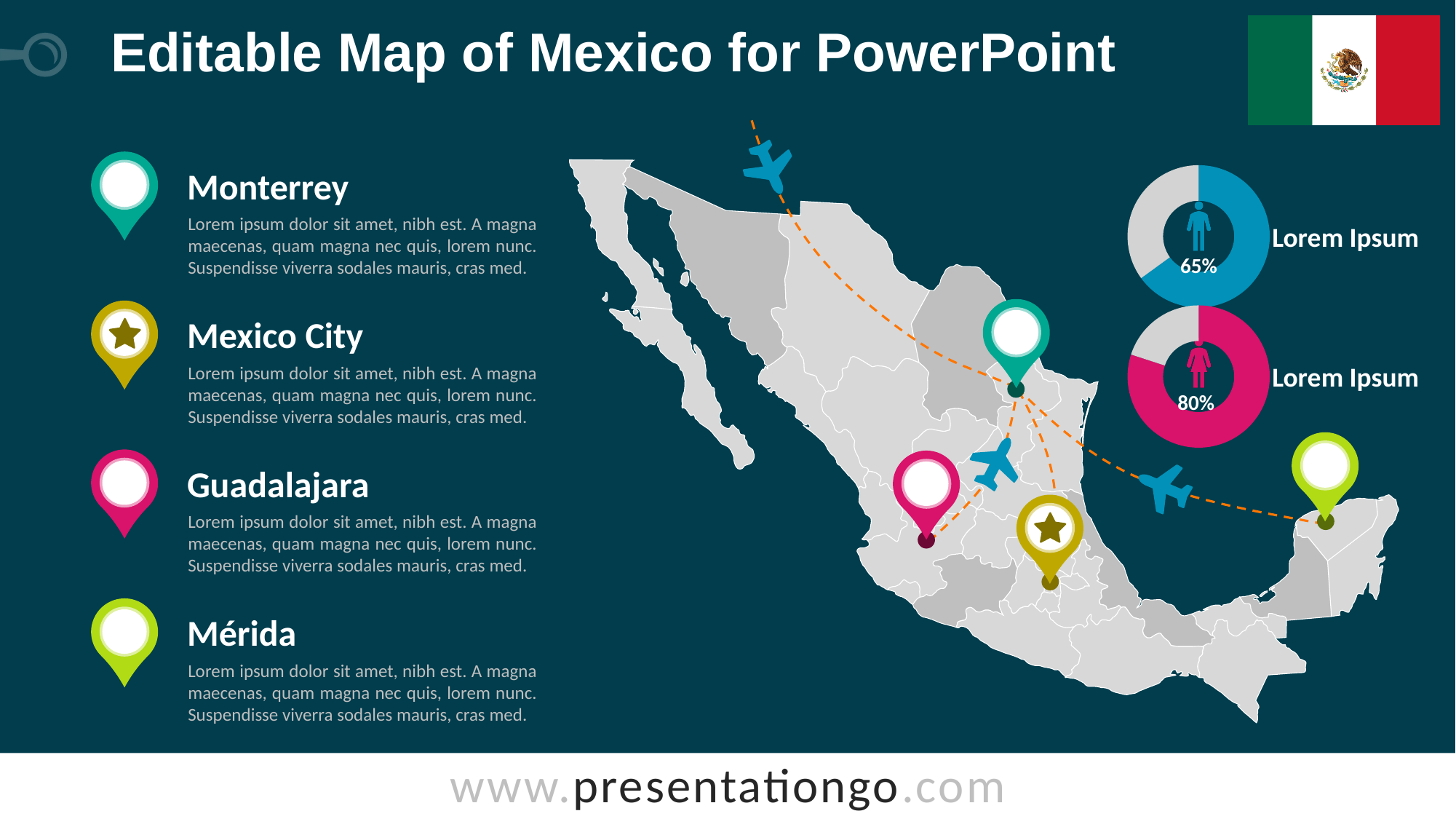
Is the value in the lower donut chart with the female icon greater or less than 75%? greater What kind of chart is used to display the 65% and 80% values on the right side of the slide? donut chart How many donut charts are on the slide? 2 What percentage is shown in the upper donut chart with the male figure icon? 65% Which donut chart shows the larger percentage, the upper one with the male icon or the lower one with the female icon? the lower one with the female icon What label text appears next to each of the two donut charts? Lorem Ipsum Is the value in the upper donut chart with the male icon greater or less than 50%? greater What is the difference between the percentage in the lower donut chart (80%) and the upper donut chart (65%)? 15% What colour is the filled portion of the upper donut chart showing 65%? blue What percentage is shown in the lower donut chart with the female figure icon? 80%